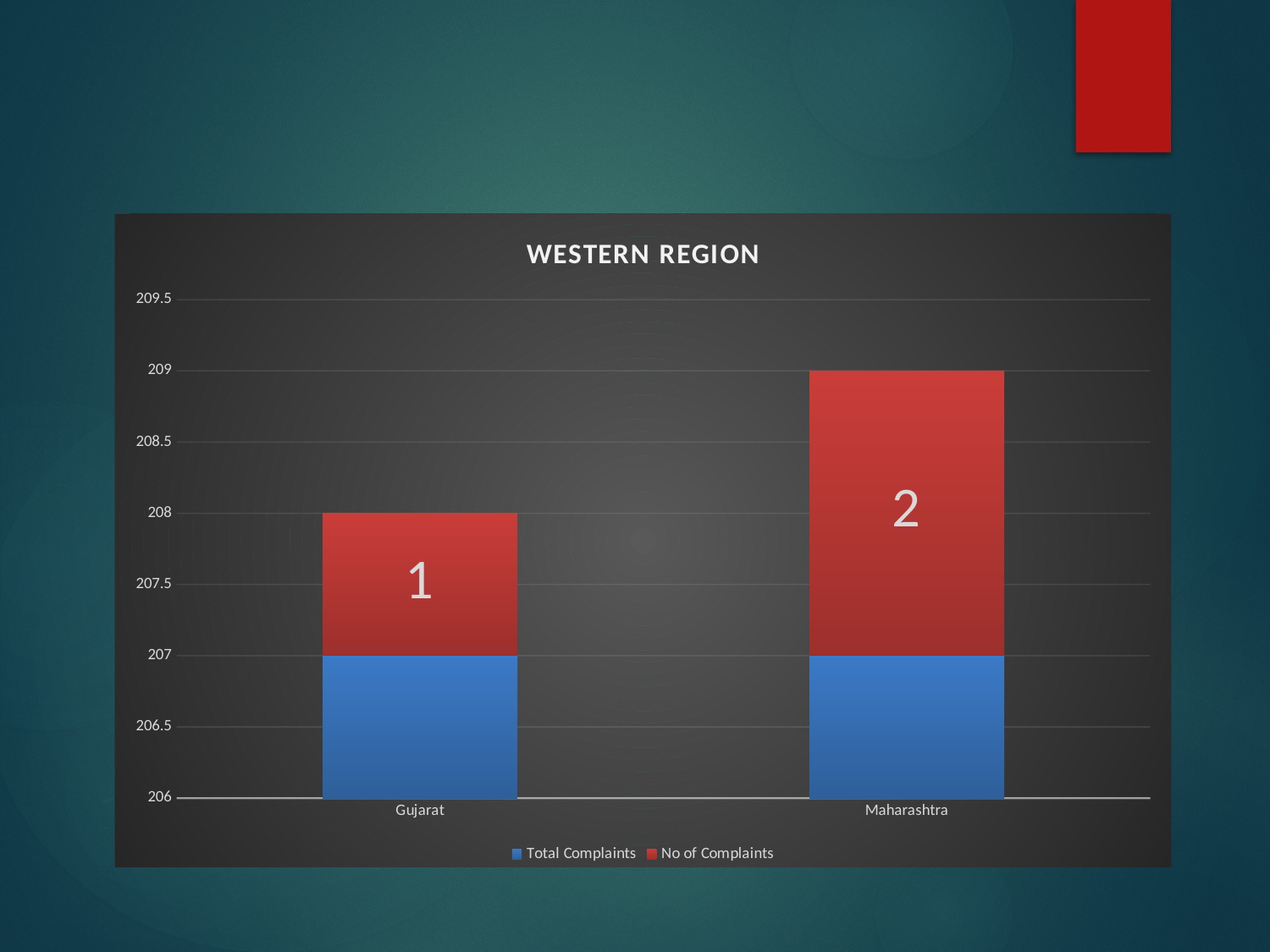
Which category has the lower No of Complaints value? Gujarat How many series does the legend list? 2 What is the title of the chart? WESTERN REGION What is the value of No of Complaints for Maharashtra? 2 Which category has the higher No of Complaints value? Maharashtra How many categories are shown on the x axis? 2 Which colour represents the No of Complaints series? Red What is the value of Total Complaints for Gujarat? 207 What is the value of No of Complaints for Gujarat? 1 What is the difference between the No of Complaints values for Maharashtra and Gujarat? 1 What kind of chart is shown on the slide? Stacked bar chart Is the No of Complaints value larger for Gujarat or Maharashtra? Maharashtra